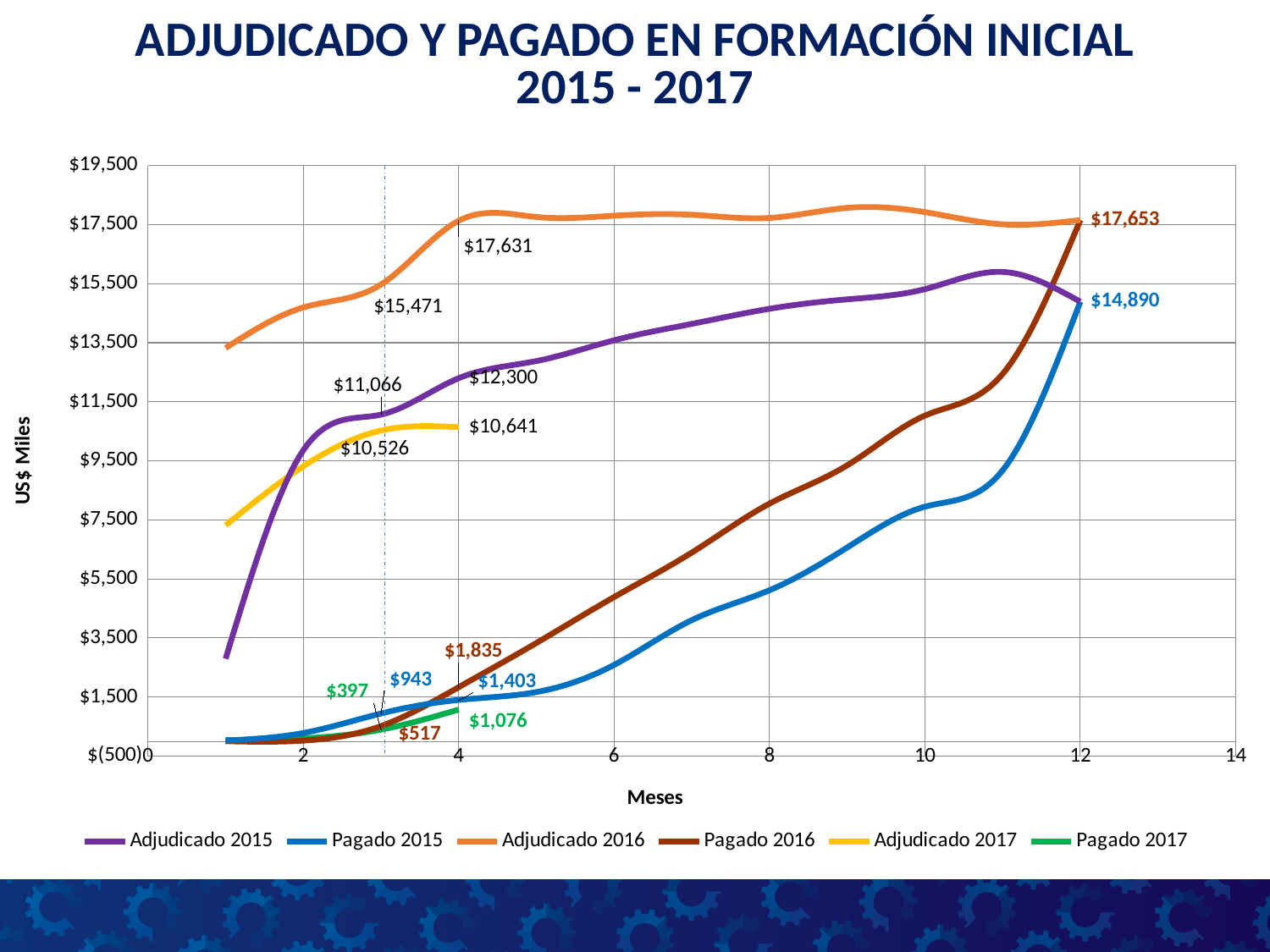
What is the labelled value of Pagado 2015 at month 12? $14,890 At month 4, which is larger: Pagado 2016 or Pagado 2015? Pagado 2016 Does the Pagado 2016 line rise or fall from month 1 to month 12? Rises Is the value of Adjudicado 2015 at month 10 greater or less than $13,500? greater What is the labelled value of Adjudicado 2015 at month 3? $11,066 What is the labelled value of Adjudicado 2017 at month 4? $10,641 How many series does the legend list? 6 Which series has the lowest labelled value at month 3? Pagado 2017 What is the title of the x axis? Meses What is the difference between the labelled values of Adjudicado 2016 and Adjudicado 2015 at month 4? $5,331 What type of chart is shown on the slide? Line chart What is the labelled value of Adjudicado 2016 at month 4? $17,631